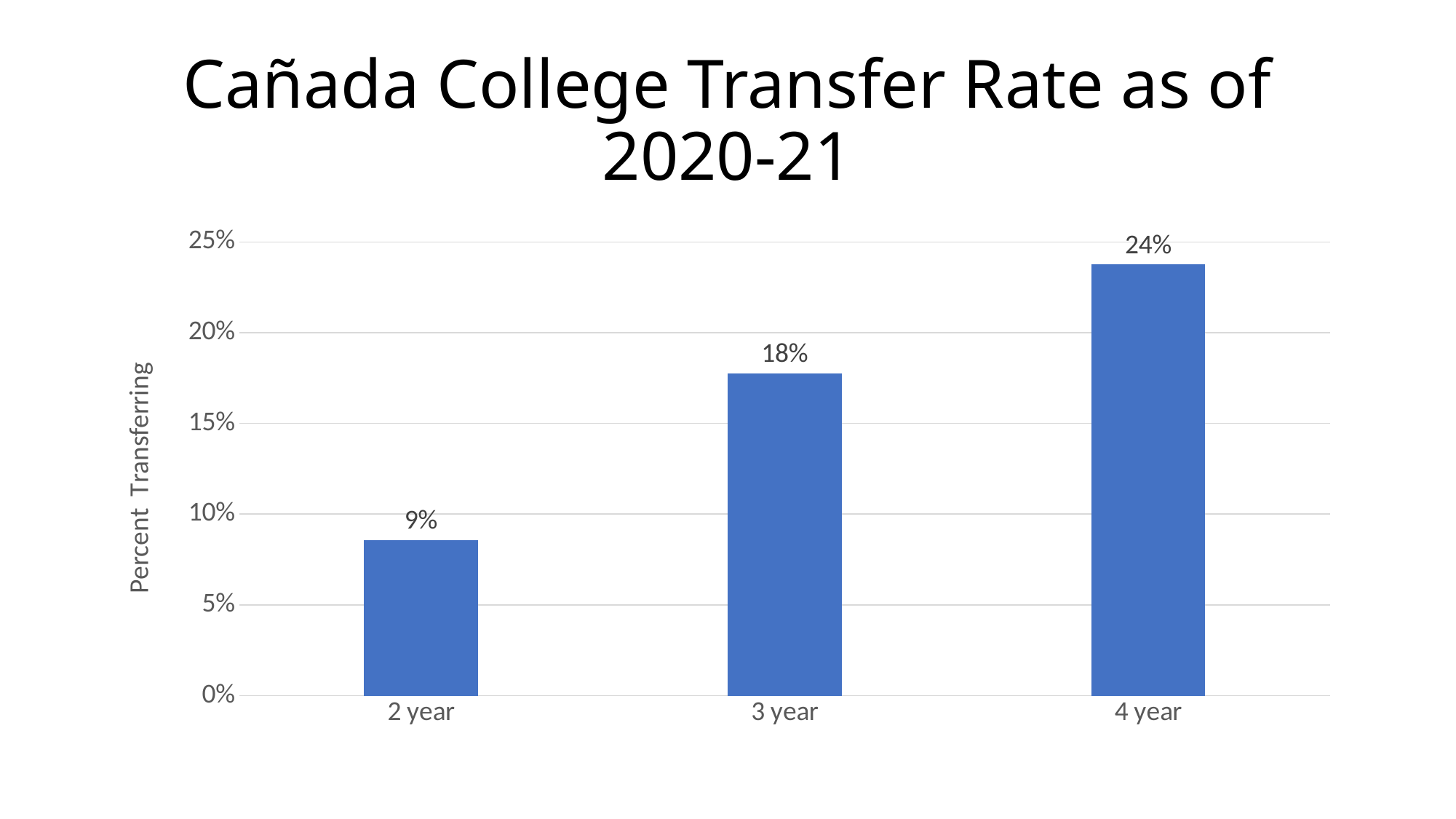
Which category has the lowest transfer rate? 2 year What is the transfer rate for 4 year? 24% Do the transfer rates rise or fall from 2 year to 4 year? Rise Which is larger, the transfer rate for 3 year or for 4 year? 4 year How many categories are shown on the x axis? 3 Which category has the highest transfer rate? 4 year Is the value for 3 year greater or less than 15%? greater What is the transfer rate for 2 year? 9% What is the difference between the 3 year and 2 year transfer rates? 9% What is the difference between the 4 year and 2 year transfer rates? 15% What is the transfer rate for 3 year? 18% What kind of chart is shown on the slide? Bar chart